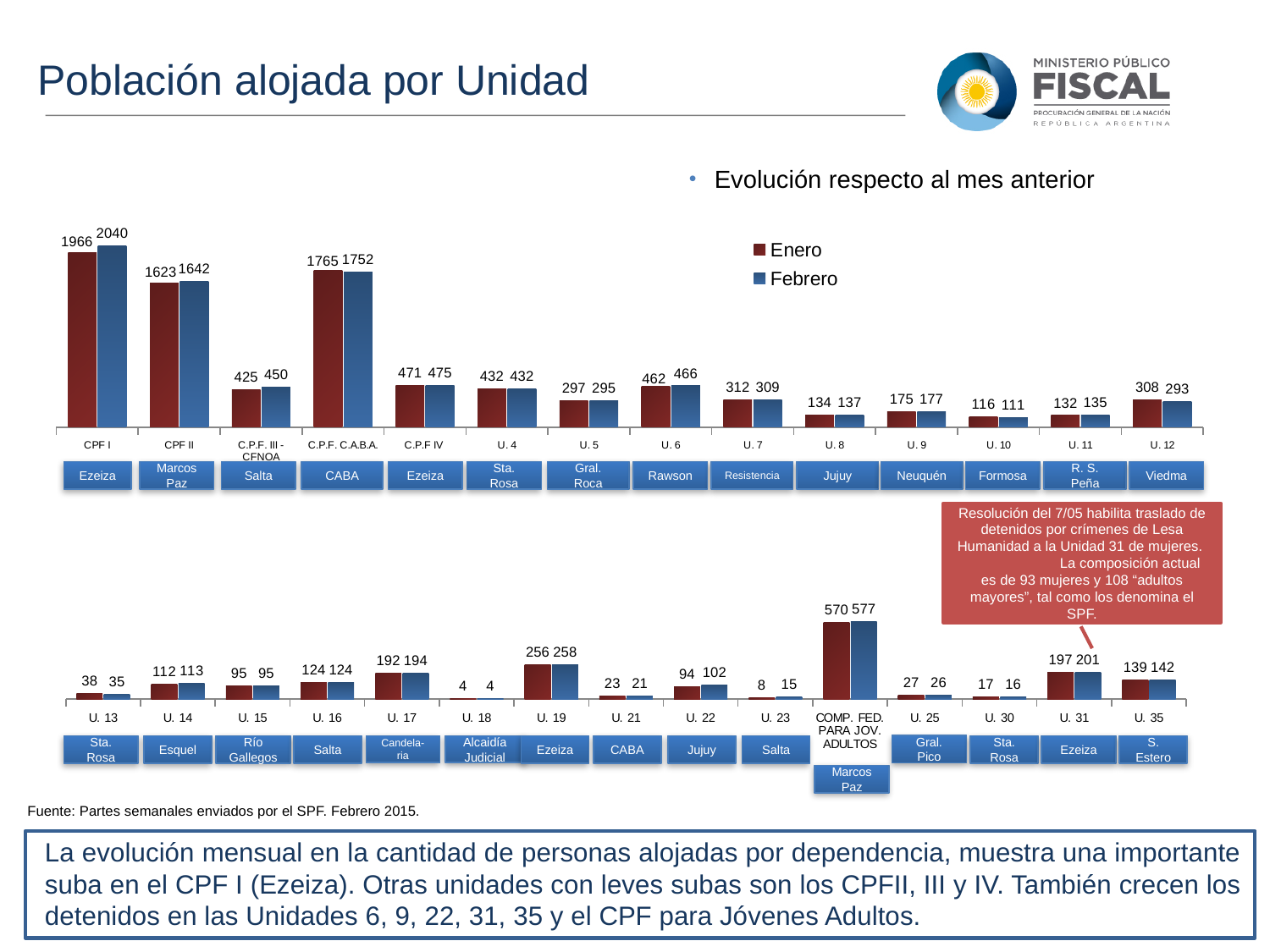
In the top chart, what is the Febrero value for CPF I? 2040 How many series does the legend of the top chart list? 2 In the top chart, which category has the highest Febrero value? CPF I In the top chart, which category has the lowest Enero value? U. 10 In the top chart, what is the difference between the Febrero and Enero values for CPF I? 74 In the top chart, which is larger for U. 12: the Enero value or the Febrero value? Enero In the bottom chart, what is the Febrero value for U. 22? 102 In the bottom chart, what is the difference between the Febrero and Enero values for U. 23? 7 In the top chart, what is the Enero value for C.P.F. C.A.B.A.? 1765 How many categories are shown in the bottom chart? 15 In the bottom chart, which category has the highest Enero value? COMP. FED. PARA JOV. ADULTOS What type of chart is the bottom chart? Bar chart